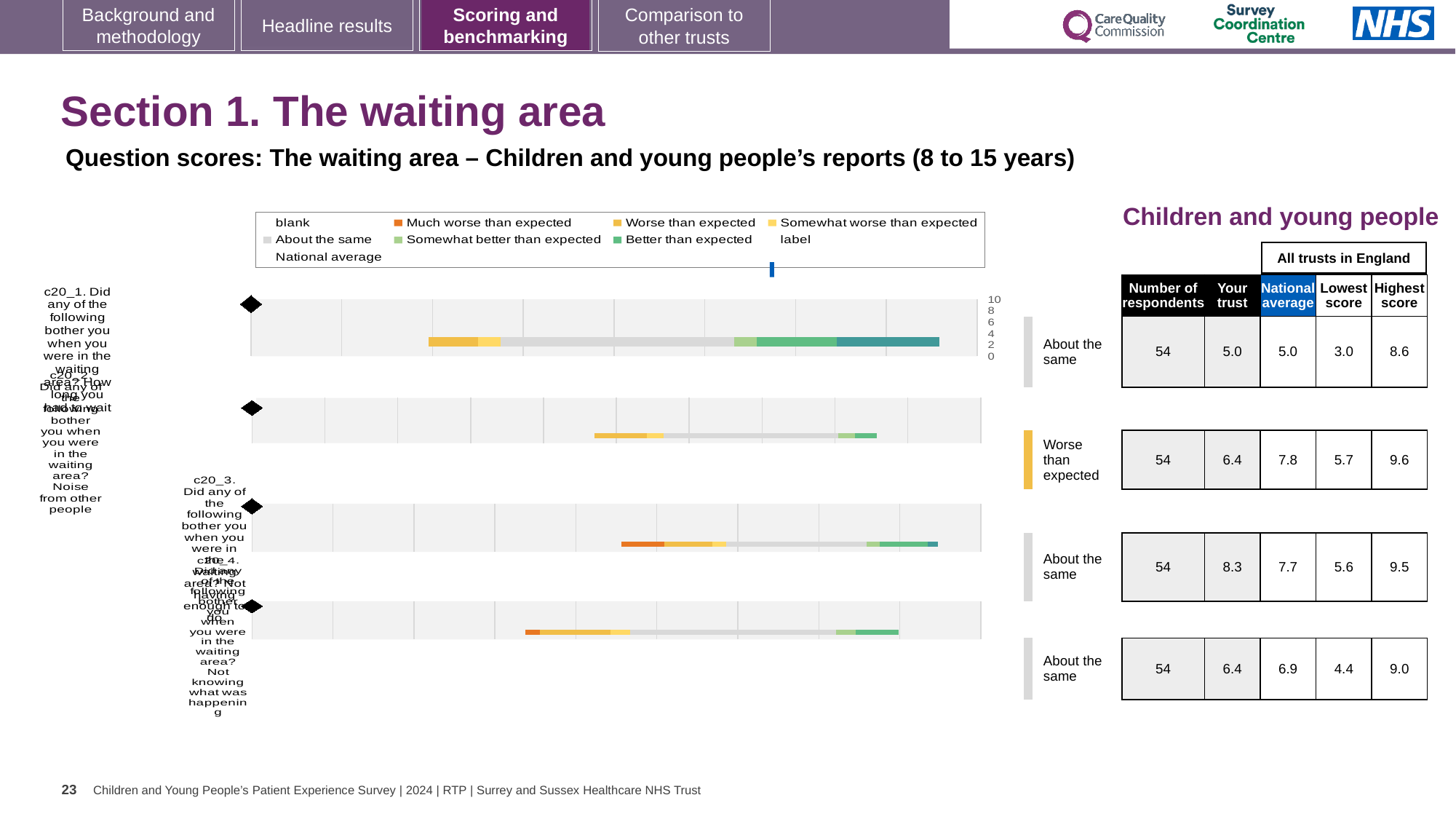
Which question has the highest 'Your trust' score in the table? c20_3 In the chart legend, which colour represents 'Much worse than expected'? orange Which question is rated 'Worse than expected' on the slide? c20_2 For the second question (c20_2), what is the difference between the National average and the 'Your trust' score? 1.4 How many question bar charts are shown on the slide? 4 In the table next to the charts, what is the Highest score for the fourth question (c20_4)? 9.0 In the table next to the charts, what is the 'Your trust' score for the second question (c20_2)? 6.4 Which question has the lowest 'Your trust' score in the table? c20_1 In the table next to the charts, what is the 'Your trust' score for the first question (c20_1)? 5.0 In the table next to the charts, what is the National average for the third question (c20_3)? 7.7 For the third question (c20_3), which is larger: the 'Your trust' score or the National average? Your trust What kind of chart is used to show the question scores on this slide? bar chart